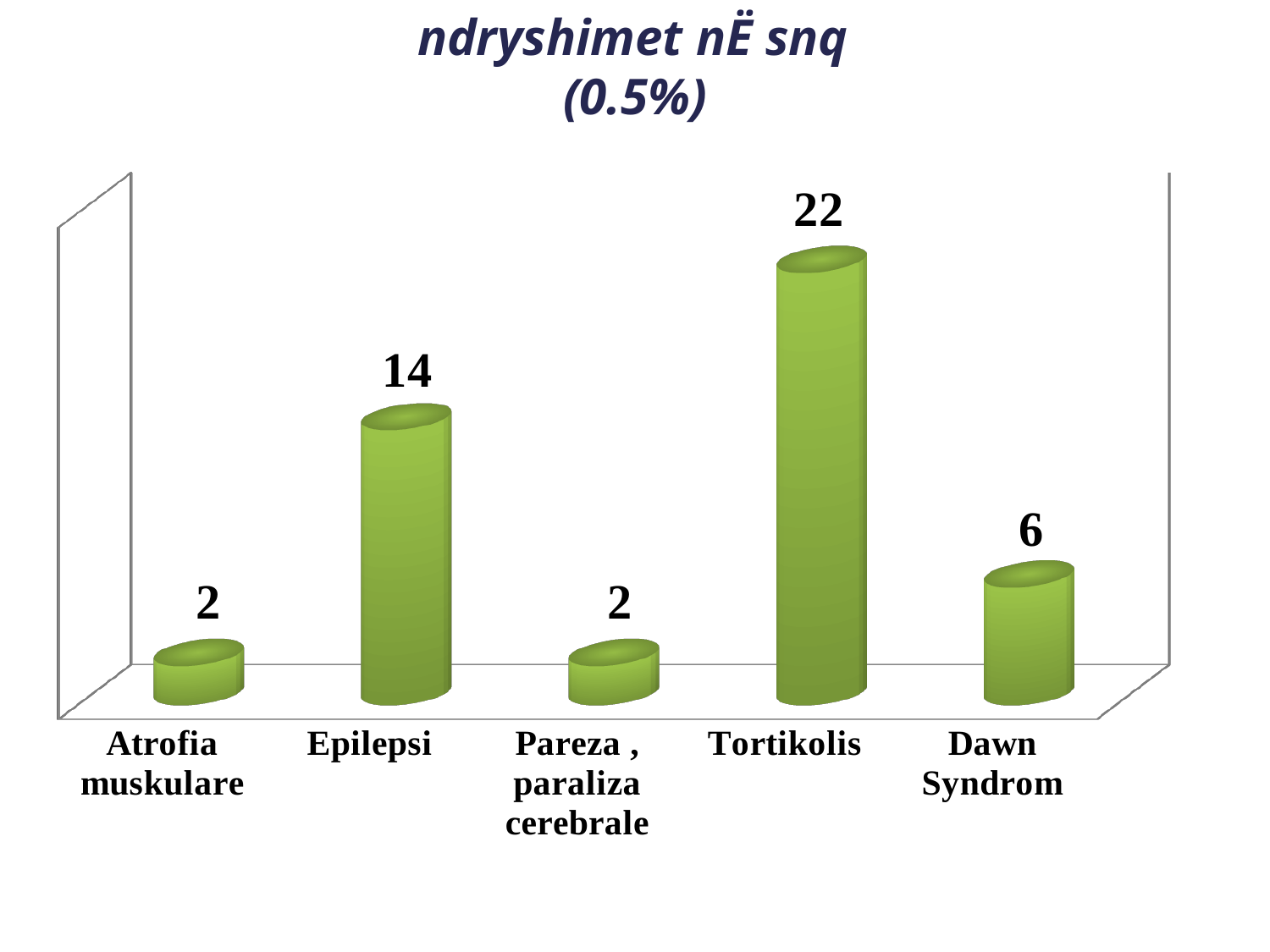
What is the difference between the values for Dawn Syndrom and Pareza, paraliza cerebrale? 4 Which category has the highest value? Tortikolis What is the value for Atrofia muskulare? 2 What kind of chart is shown on the slide? bar chart What is the difference between the values for Tortikolis and Epilepsi? 8 What colour are the bars in the chart? green What is the value for Dawn Syndrom? 6 Which is larger, the value for Epilepsi or the value for Dawn Syndrom? Epilepsi What is the value for Tortikolis? 22 What is the title of the chart? ndryshimet nË snq (0.5%) What is the value for Epilepsi? 14 How many categories are shown in the chart? 5